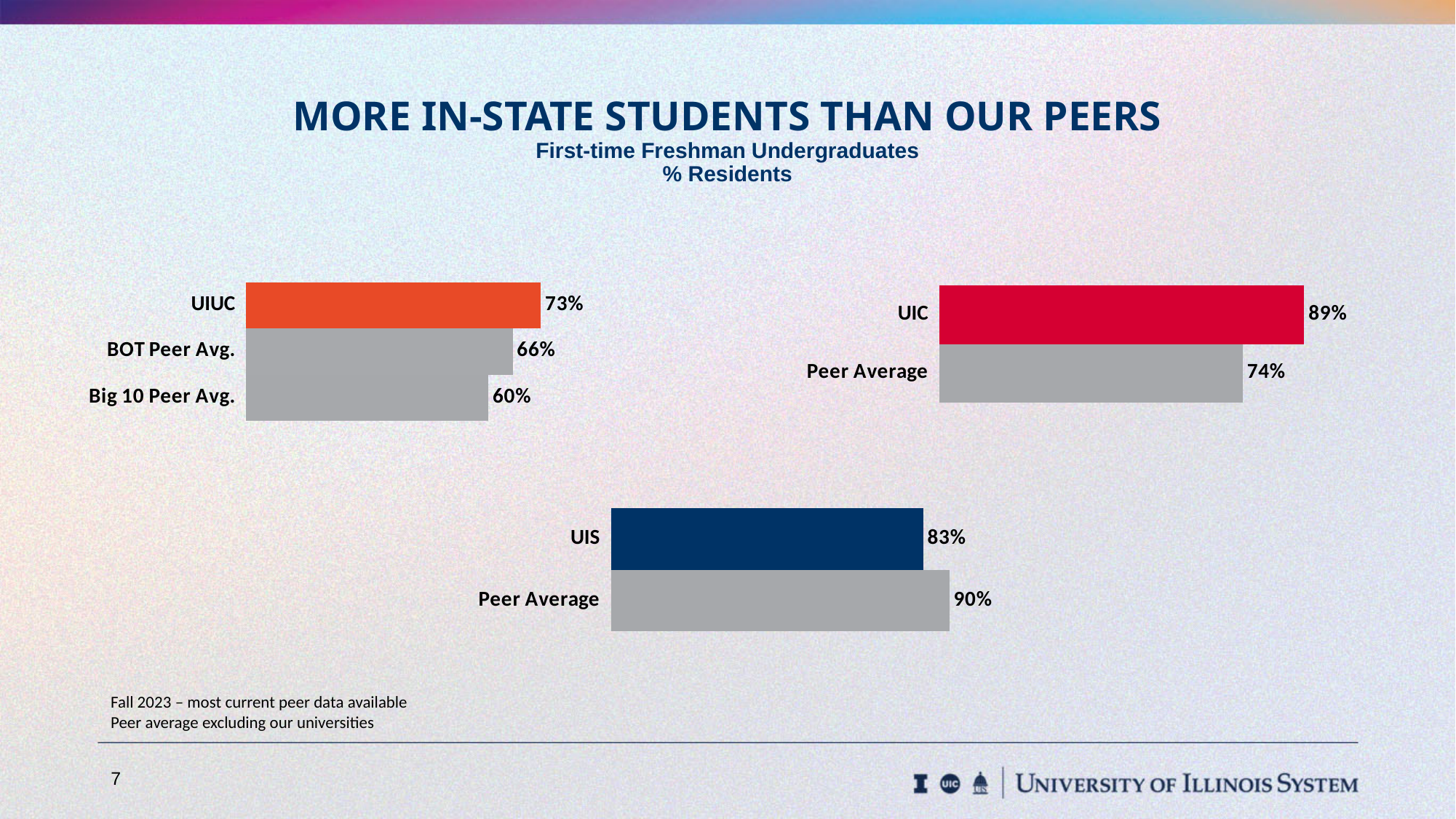
In the top-left chart (UIUC), which category has the lowest value? Big 10 Peer Avg. In the bottom chart (UIS), what is the difference between Peer Average and UIS? 7% In the top-right chart (UIC), which is larger, UIC or Peer Average? UIC In the top-right chart (UIC), what is the value for Peer Average? 74% In the bottom chart (UIS), which is larger, UIS or Peer Average? Peer Average What kind of chart is the bottom chart (UIS)? Bar chart In the top-right chart (UIC), what is the difference between UIC and Peer Average? 15% In the top-left chart (UIUC), what is the value for Big 10 Peer Avg.? 60% In the top-left chart (UIUC), how many bars are plotted? 3 In the top-left chart (UIUC), what is the value for UIUC? 73% In the top-left chart (UIUC), what is the difference between UIUC and BOT Peer Avg.? 7% In the bottom chart (UIS), what is the value for UIS? 83%